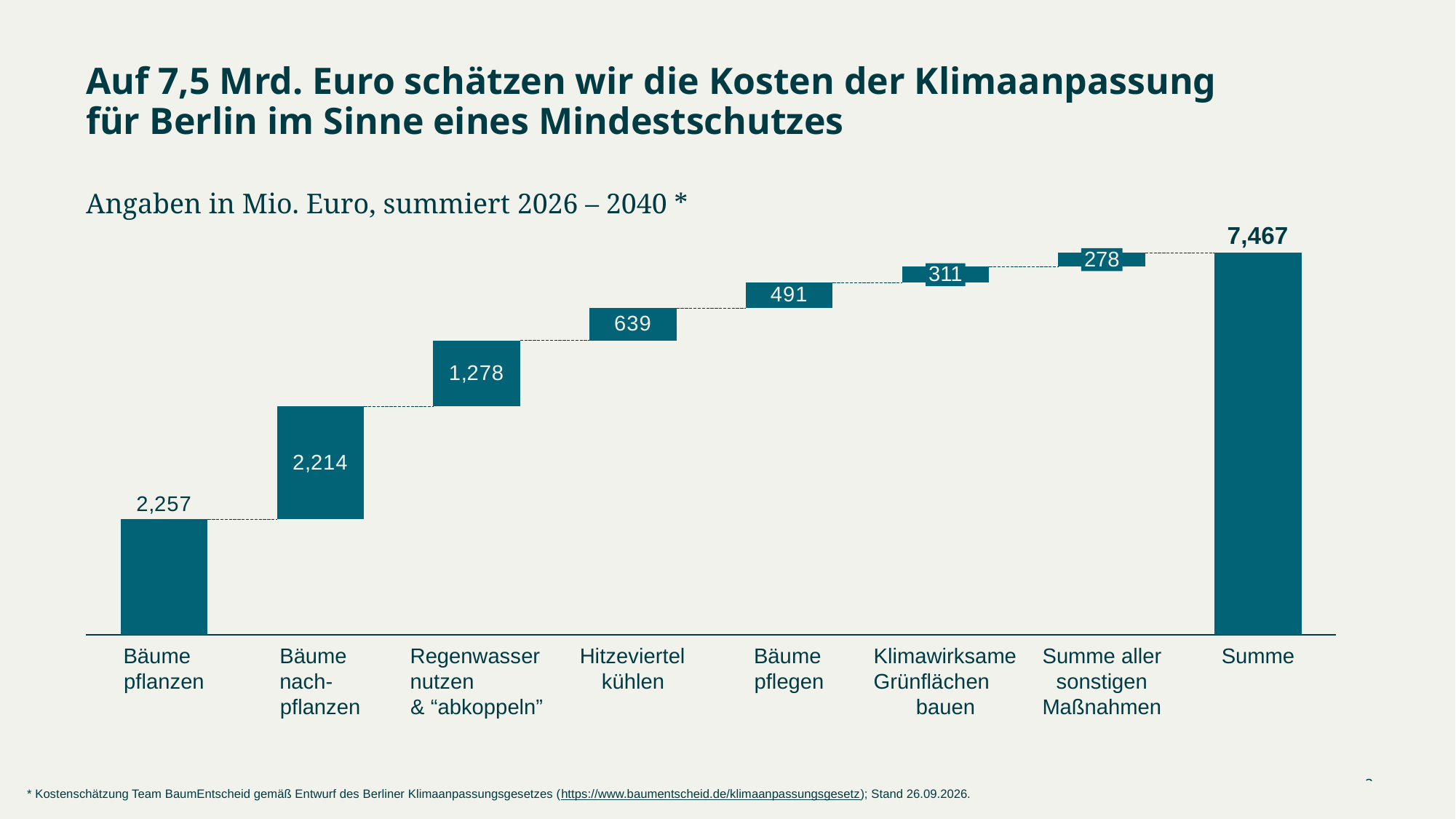
What is the difference between Bäume pflanzen and Bäume nachpflanzen? 43 Which individual measure has the lowest value? Summe aller sonstigen Maßnahmen How many bars are plotted in the chart, including the Summe bar? 8 In what unit are the values given, according to the subtitle? Mio. Euro What is the value shown for Summe aller sonstigen Maßnahmen? 278 Which individual measure (excluding Summe) has the highest value? Bäume pflanzen What is the value for Bäume pflanzen? 2,257 What is the value for Regenwasser nutzen & "abkoppeln"? 1,278 What is the value of the final Summe bar? 7,467 What is the difference between Hitzeviertel kühlen and Bäume pflegen? 148 What is the value for Hitzeviertel kühlen? 639 Which is larger, Klimawirksame Grünflächen bauen or Bäume pflegen? Bäume pflegen